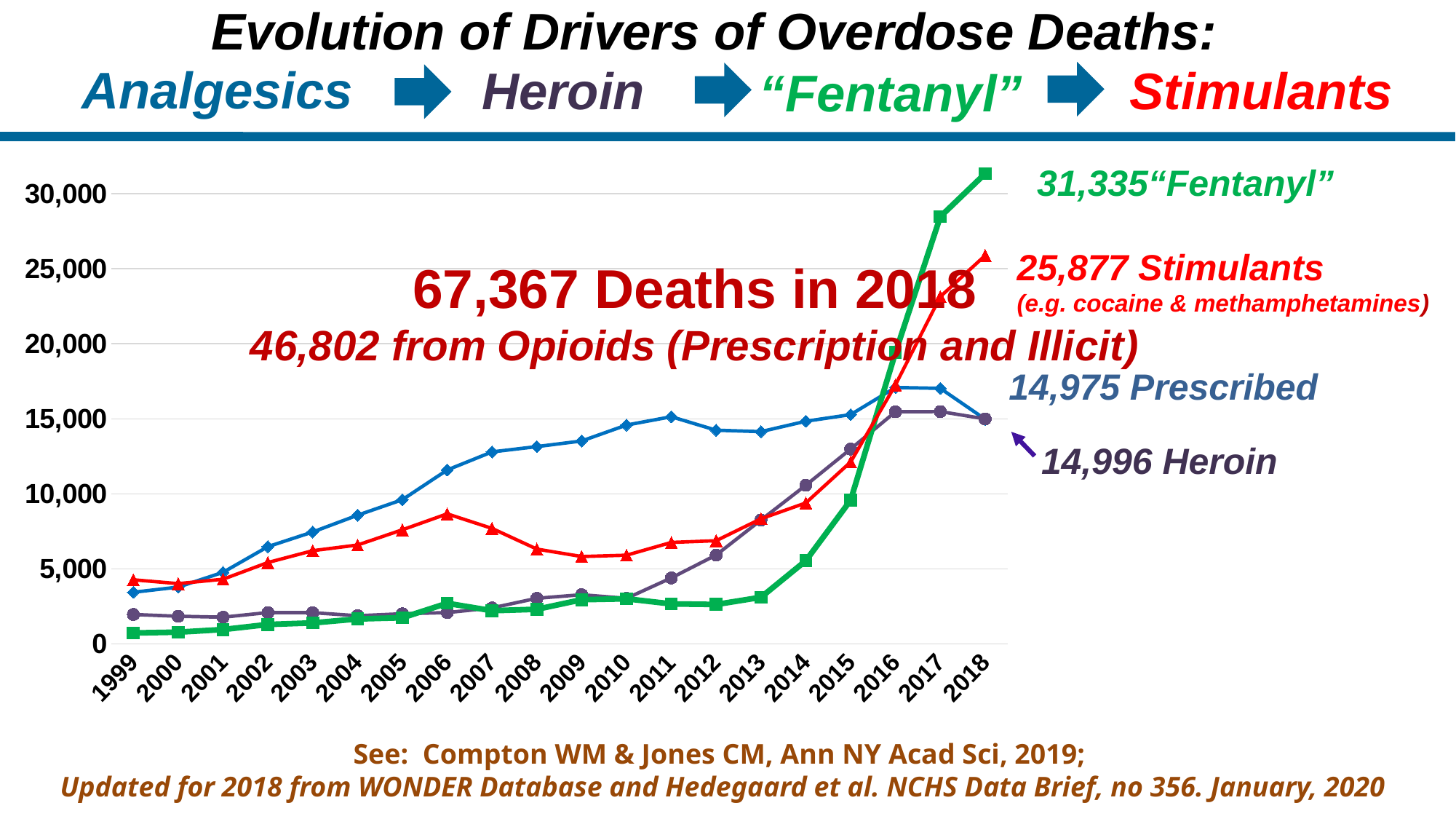
What is the 2018 value labeled for Stimulants? 25,877 What is the 2018 value labeled for Prescribed? 14,975 Is the "Fentanyl" value for 2013 greater or less than 5,000? less How many years are shown on the x axis? 20 How many deaths does the chart label for "Fentanyl" in 2018? 31,335 Which series has the highest value in 2018? "Fentanyl" What kind of chart is shown on the slide? line chart What is the 2018 value labeled for Heroin? 14,996 Does the "Fentanyl" line rise or fall from 2013 to 2018? rises Which is larger in 2018, the Heroin value or the Prescribed value? Heroin What is the difference between the 2018 "Fentanyl" value and the 2018 Stimulants value? 5,458 What colour is the "Fentanyl" line on the chart? green